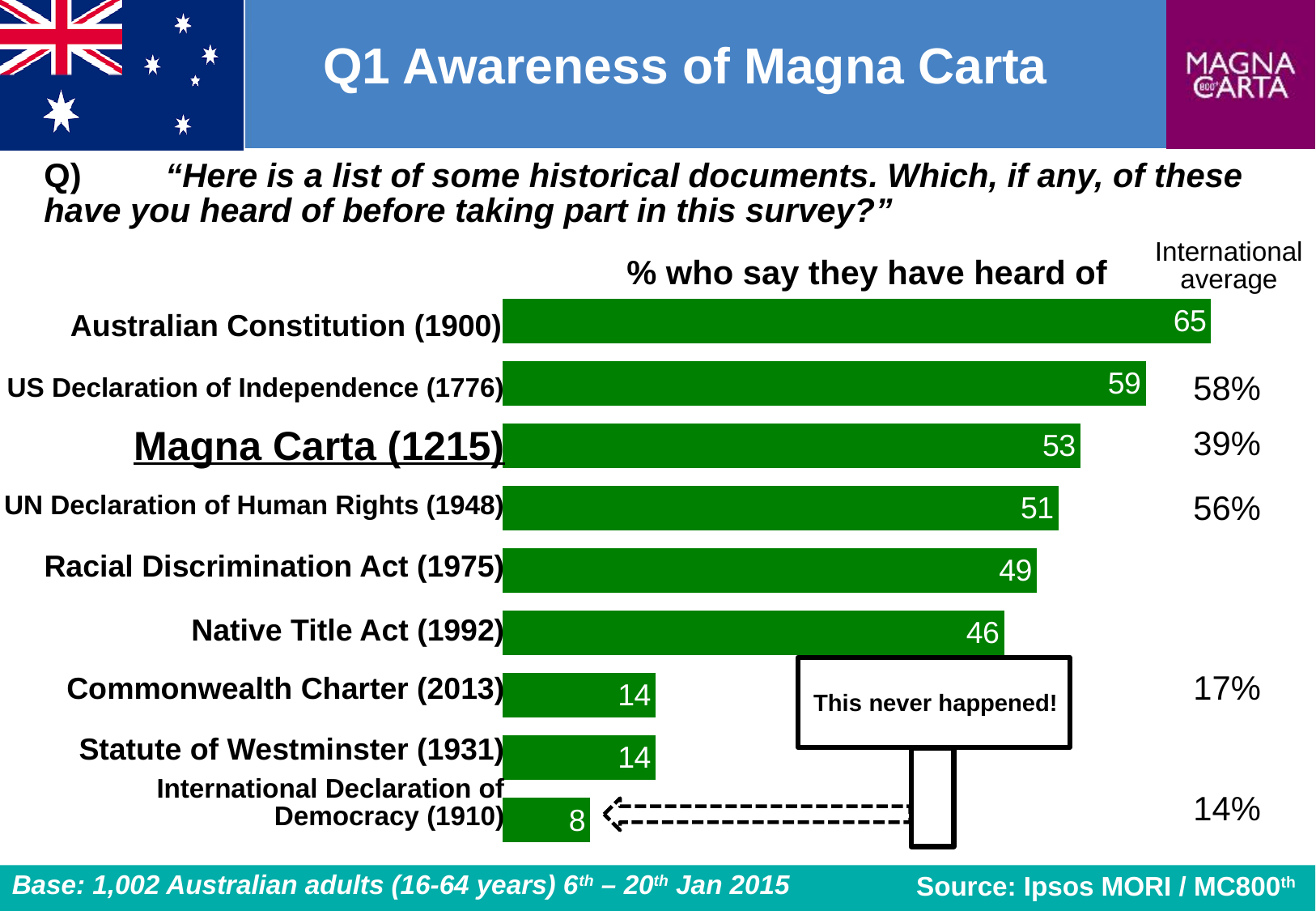
Which has a higher value: the UN Declaration of Human Rights (1948) or the Racial Discrimination Act (1975)? UN Declaration of Human Rights (1948) How many documents are listed in the bar chart? 9 What is the value shown for the Australian Constitution (1900)? 65 What is the difference between the values for the US Declaration of Independence (1776) and the Magna Carta (1215)? 6 What kind of chart is shown on the slide? Bar chart What does the text in the box pointing to the International Declaration of Democracy (1910) bar say? This never happened! What is the international average shown for the Magna Carta (1215)? 39% What percentage of respondents say they have heard of the Magna Carta (1215)? 53 Which document has the highest percentage of people who say they have heard of it? Australian Constitution (1900) Which document has the lowest percentage of people who say they have heard of it? International Declaration of Democracy (1910) What value is shown for the Native Title Act (1992)? 46 What is the difference between the Australian value for the Magna Carta (1215) and its international average? 14